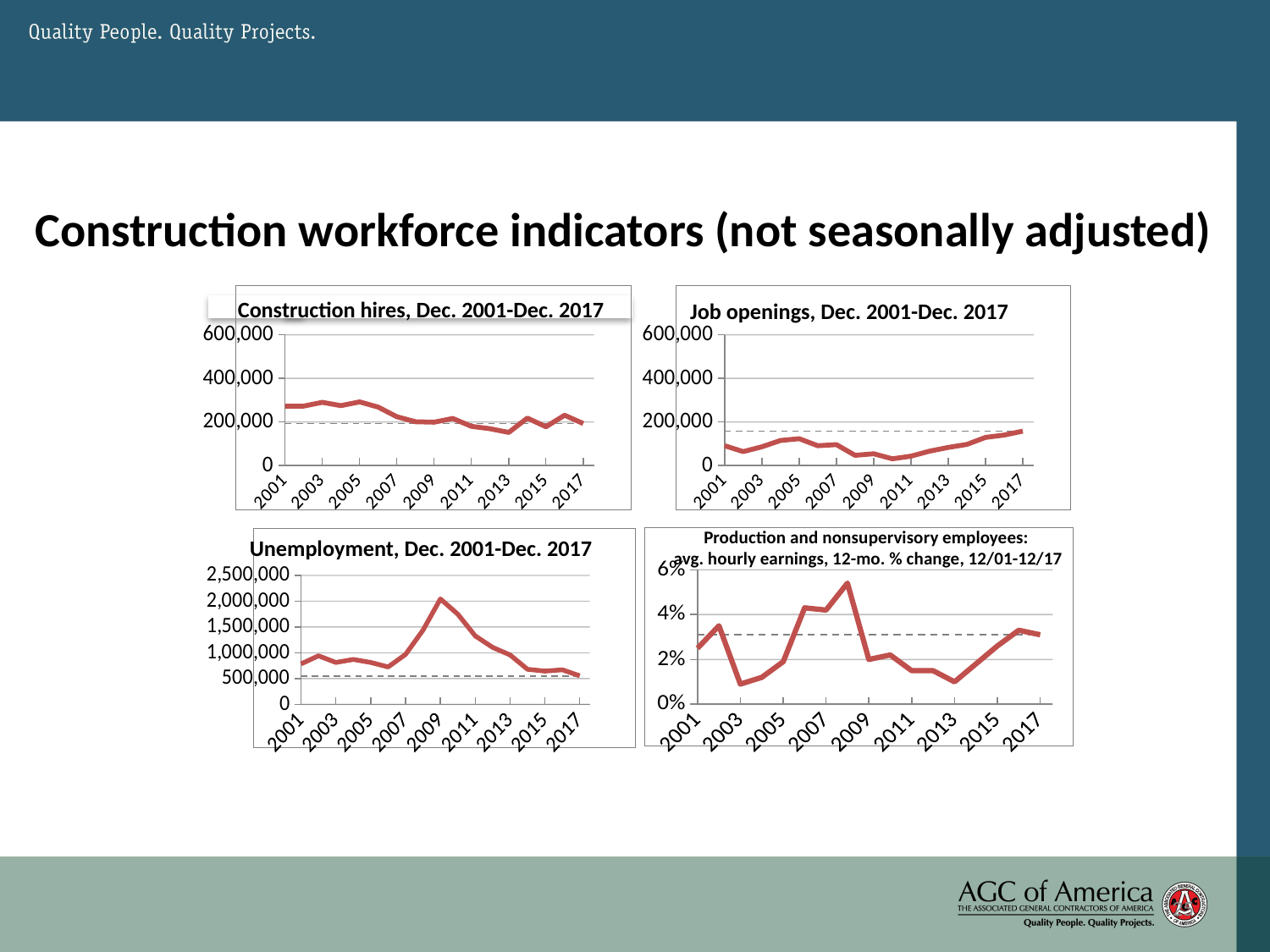
What is the title of the top-left chart? Construction hires, Dec. 2001-Dec. 2017 In the 'Job openings, Dec. 2001-Dec. 2017' chart, which year has the lowest value? 2010 In the bottom-right chart on average hourly earnings, is the value for 2013 greater or less than 2%? less What kind of chart is the 'Unemployment, Dec. 2001-Dec. 2017' chart? line chart In the 'Job openings, Dec. 2001-Dec. 2017' chart, is the value for 2017 greater or less than 200,000? less In the 'Construction hires, Dec. 2001-Dec. 2017' chart, is the value for 2013 greater or less than 200,000? less In the 'Job openings, Dec. 2001-Dec. 2017' chart, do values rise or fall from 2011 to 2017? rise In the 'Unemployment, Dec. 2001-Dec. 2017' chart, do values rise or fall from 2009 to 2017? fall In the 'Unemployment, Dec. 2001-Dec. 2017' chart, which year has the highest value? 2009 How many charts are shown on the slide? 4